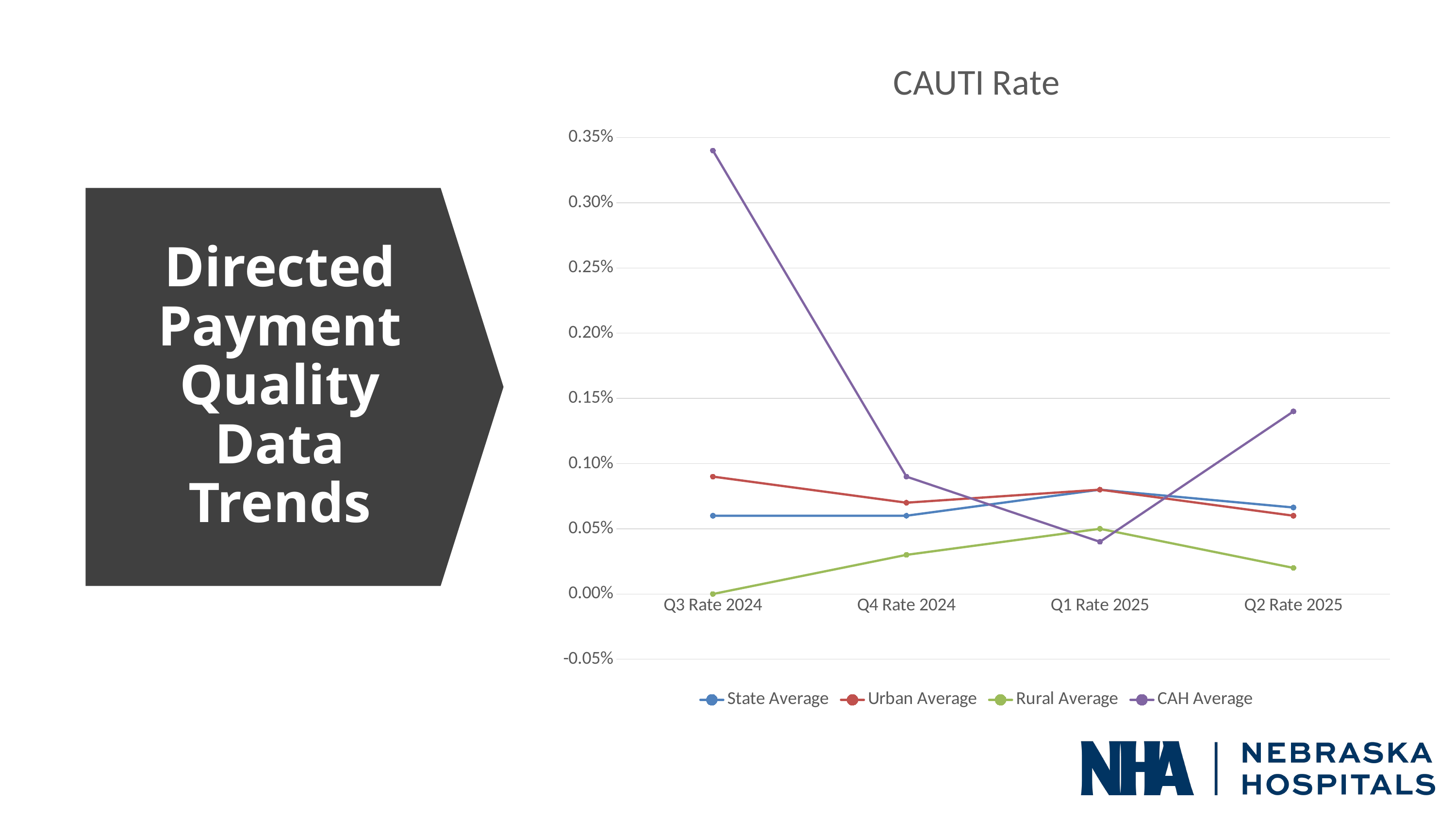
Which colour is used for the CAH Average line? purple How many quarters are plotted along the x axis? 4 Is the Rural Average value for Q2 Rate 2025 greater or less than 0.05%? less What is the title of the chart? CAUTI Rate What is the Rural Average value for Q3 Rate 2024? 0.00% How many series does the legend list? 4 Which series has the lowest value at Q2 Rate 2025? Rural Average What type of chart is shown on the slide? line chart Does the CAH Average rise or fall from Q3 Rate 2024 to Q1 Rate 2025? fall Which series has the highest value at Q3 Rate 2024? CAH Average Is the CAH Average value for Q3 Rate 2024 greater or less than 0.30%? greater At Q3 Rate 2024, which is higher: the Urban Average or the State Average? Urban Average